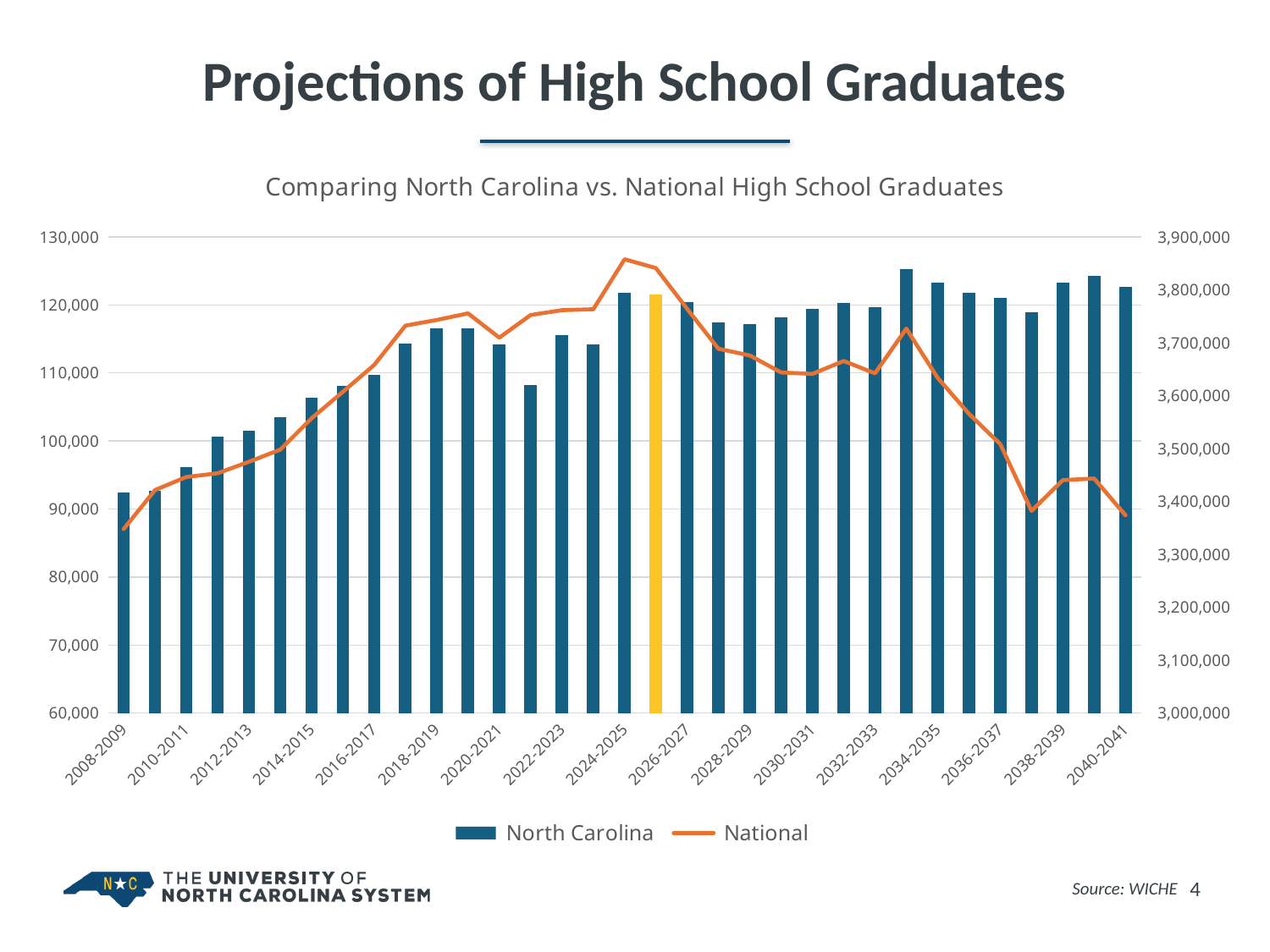
Is the North Carolina value for 2008-2009 greater or less than 100,000? less How many bars (school years) are plotted for North Carolina? 33 Does the National line rise or fall from 2024-2025 to 2040-2041? fall What is the title of the chart? Comparing North Carolina vs. National High School Graduates Is the National value for 2024-2025 greater or less than 3,800,000? greater How many series does the legend list? 2 What kind of chart is this? Combined bar and line chart Which school year has the lowest North Carolina value? 2008-2009 Is the North Carolina value for 2034-2035 greater or less than 120,000? greater In which school year does the National line reach its peak? 2024-2025 Which is larger, the North Carolina value for 2008-2009 or for 2040-2041? 2040-2041